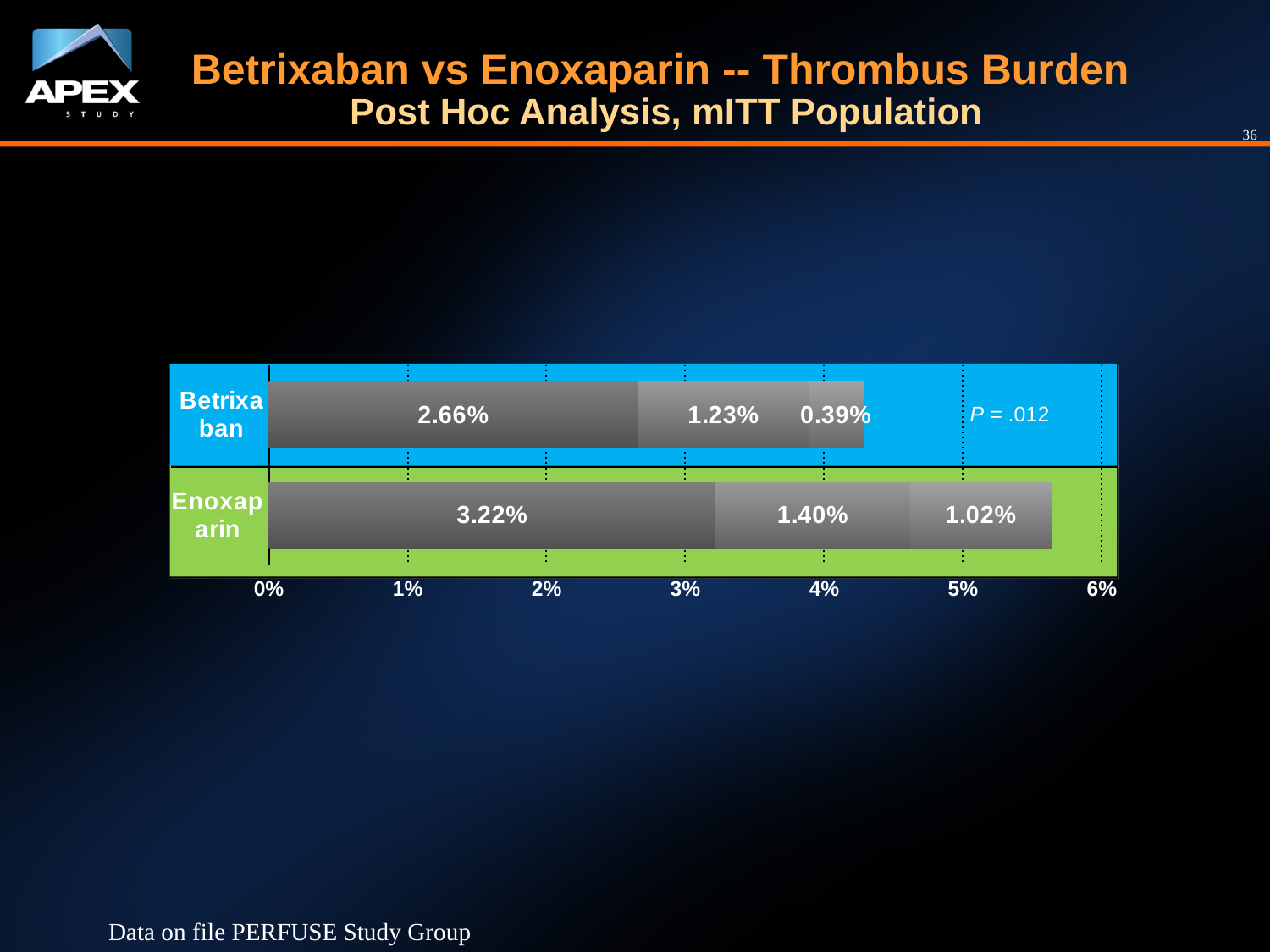
Which bar has the larger rightmost segment, Betrixaban or Enoxaparin? Enoxaparin What is the value of the third (rightmost) segment of the Betrixaban bar? 0.39% What is the value of the first (largest) segment of the Betrixaban bar? 2.66% What is the total of the stacked Betrixaban bar? 4.28% What kind of chart is shown on the slide? Stacked bar chart How many categories (bars) are shown in the chart? 2 What is the value of the middle segment of the Enoxaparin bar? 1.40% What is the difference between the first segments of the Enoxaparin bar (3.22%) and the Betrixaban bar (2.66%)? 0.56% What is the total of the stacked Enoxaparin bar? 5.64% What is the value of the first (largest) segment of the Enoxaparin bar? 3.22% What P value is printed on the chart? P = .012 Is the total length of the Enoxaparin bar greater or less than 5%? greater